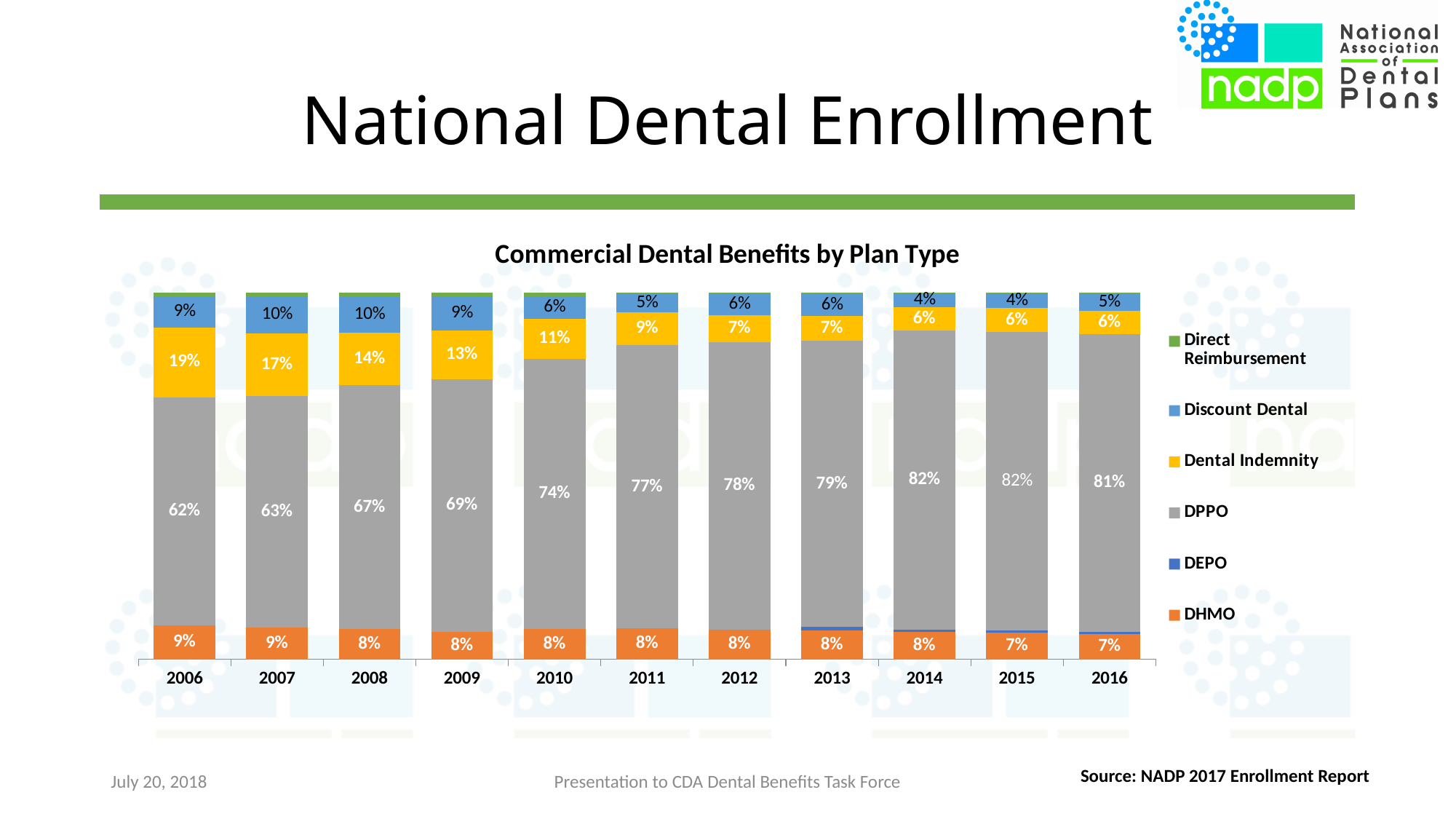
How many years are shown along the x axis? 11 In which year is the DPPO share lowest? 2006 What is the DHMO share in 2016? 7% How many series does the legend list? 6 What is the title of the chart? Commercial Dental Benefits by Plan Type What is the Dental Indemnity share in 2010? 11% What type of chart is shown on the slide? Stacked bar chart What is the Discount Dental share in 2007? 10% What is the difference between the DPPO share in 2016 and in 2006? 19 percentage points Does the DPPO share generally rise or fall from 2006 to 2016? Rise In which year is the Dental Indemnity share highest? 2006 What is the DPPO share in 2006? 62%